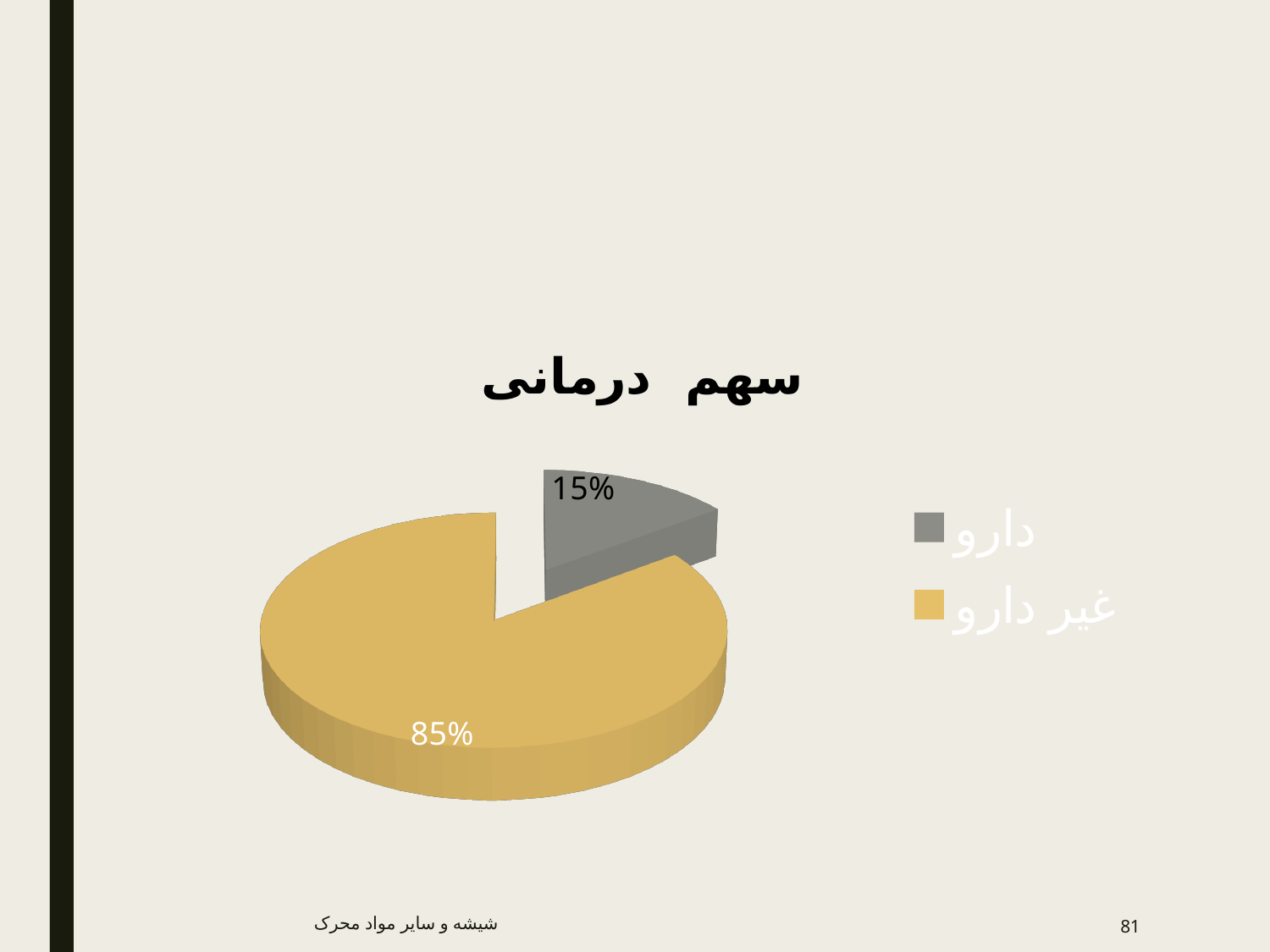
What share of the pie does غیر دارو have? 85% What is the difference between the shares of غیر دارو and دارو? 70% What share of the pie does دارو have? 15% How many slices does the pie chart have? 2 What kind of chart is shown on the slide? pie chart Which is larger, the share of دارو or the share of غیر دارو? غیر دارو Which slice is the largest? غیر دارو What is the title of the chart? سهم درمانی What colour is the slice for دارو? grey How many entries does the legend list? 2 Which slice is the smallest? دارو